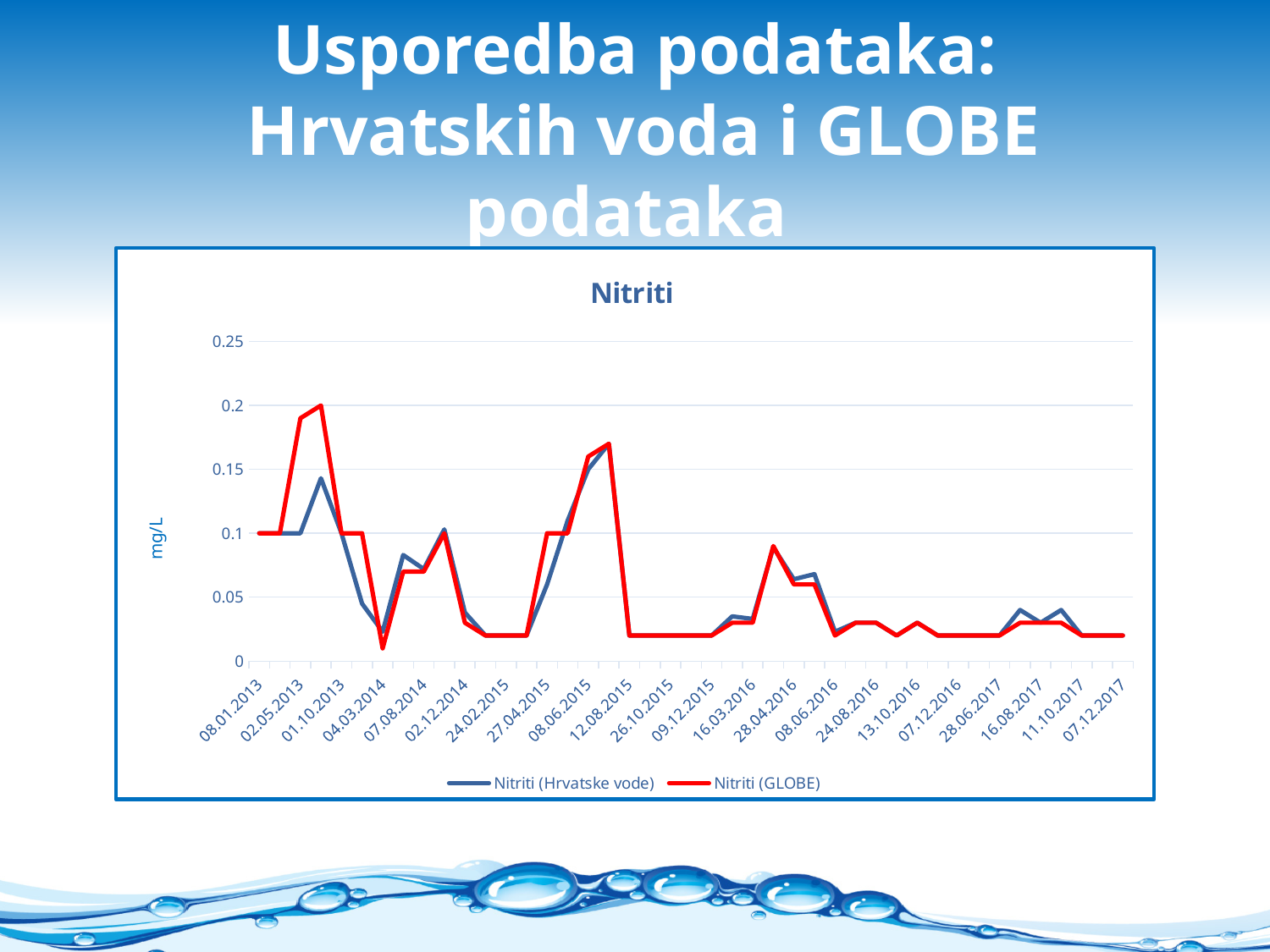
What are the two series named in the legend of the Nitriti chart? Nitriti (Hrvatske vode) and Nitriti (GLOBE) What kind of chart is shown on the slide? line chart Overall, do the nitrite values rise or fall from 2013 to 2017? fall Is the value of Nitriti (GLOBE) at 12.08.2015 greater or less than 0.05? less Which series reaches the higher peak value, Nitriti (Hrvatske vode) or Nitriti (GLOBE)? Nitriti (GLOBE) What unit is shown on the vertical axis of the Nitriti chart? mg/L Is the highest value of the Nitriti (GLOBE) series greater or less than 0.15? greater Is the value of Nitriti (Hrvatske vode) at 07.12.2017 greater or less than 0.05? less What is the value of the Nitriti (GLOBE) series at 08.01.2013? 0.1 How many series does the legend of the Nitriti chart list? 2